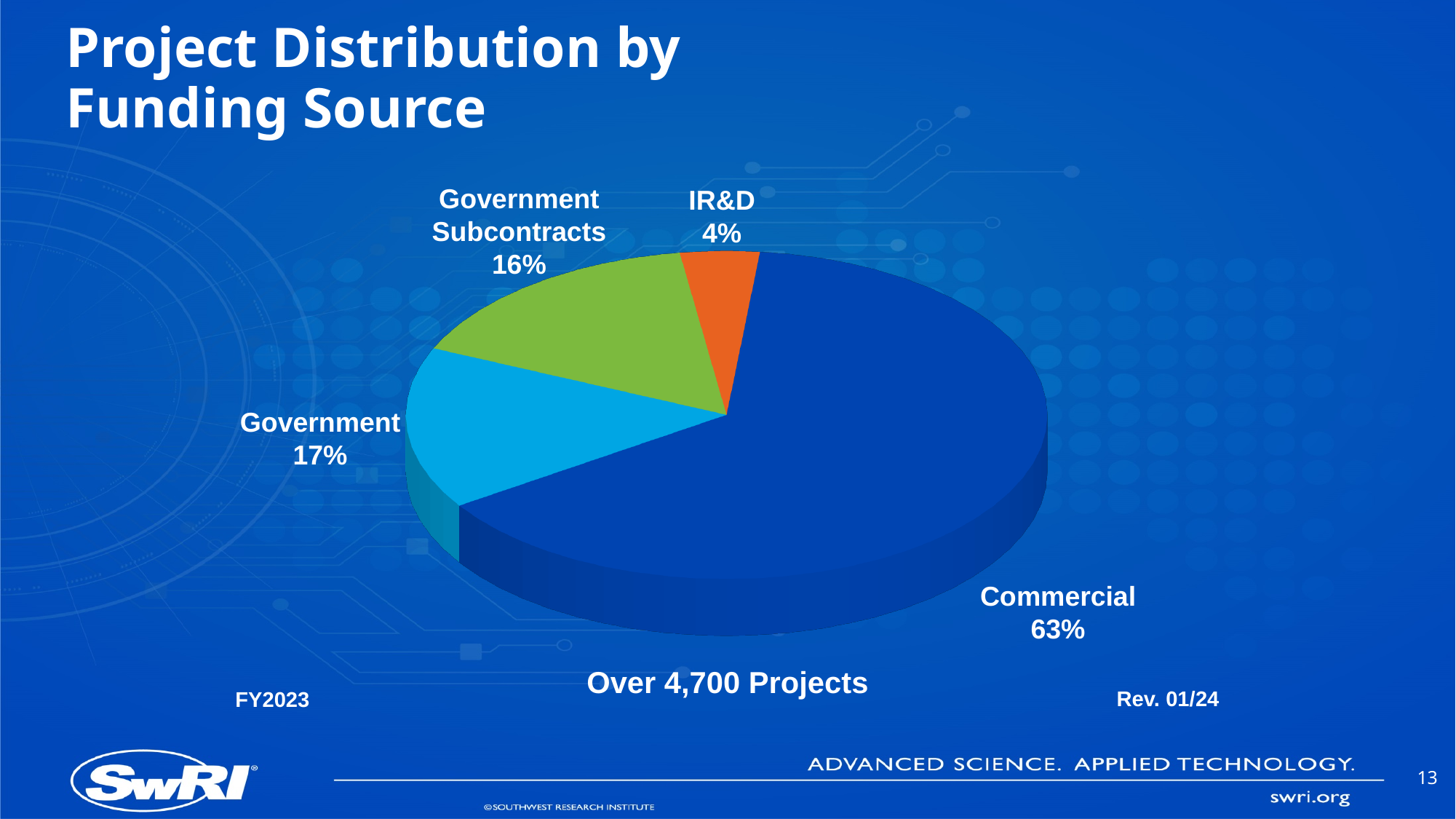
What share of projects is funded by IR&D? 4% Which is larger, the Government share or the Government Subcontracts share? Government What share of projects is funded by Government? 17% What share of projects is funded by Government Subcontracts? 16% How many funding source categories are shown in the pie chart? 4 Which funding source has the smallest share of projects? IR&D What kind of chart is shown on the slide? Pie chart Which funding source has the largest share of projects? Commercial What share of projects is funded by Commercial sources? 63% What is the combined share of Government and Government Subcontracts? 33% What is the difference in percentage points between the Commercial and Government shares? 46 What is the title of the chart on the slide? Project Distribution by Funding Source